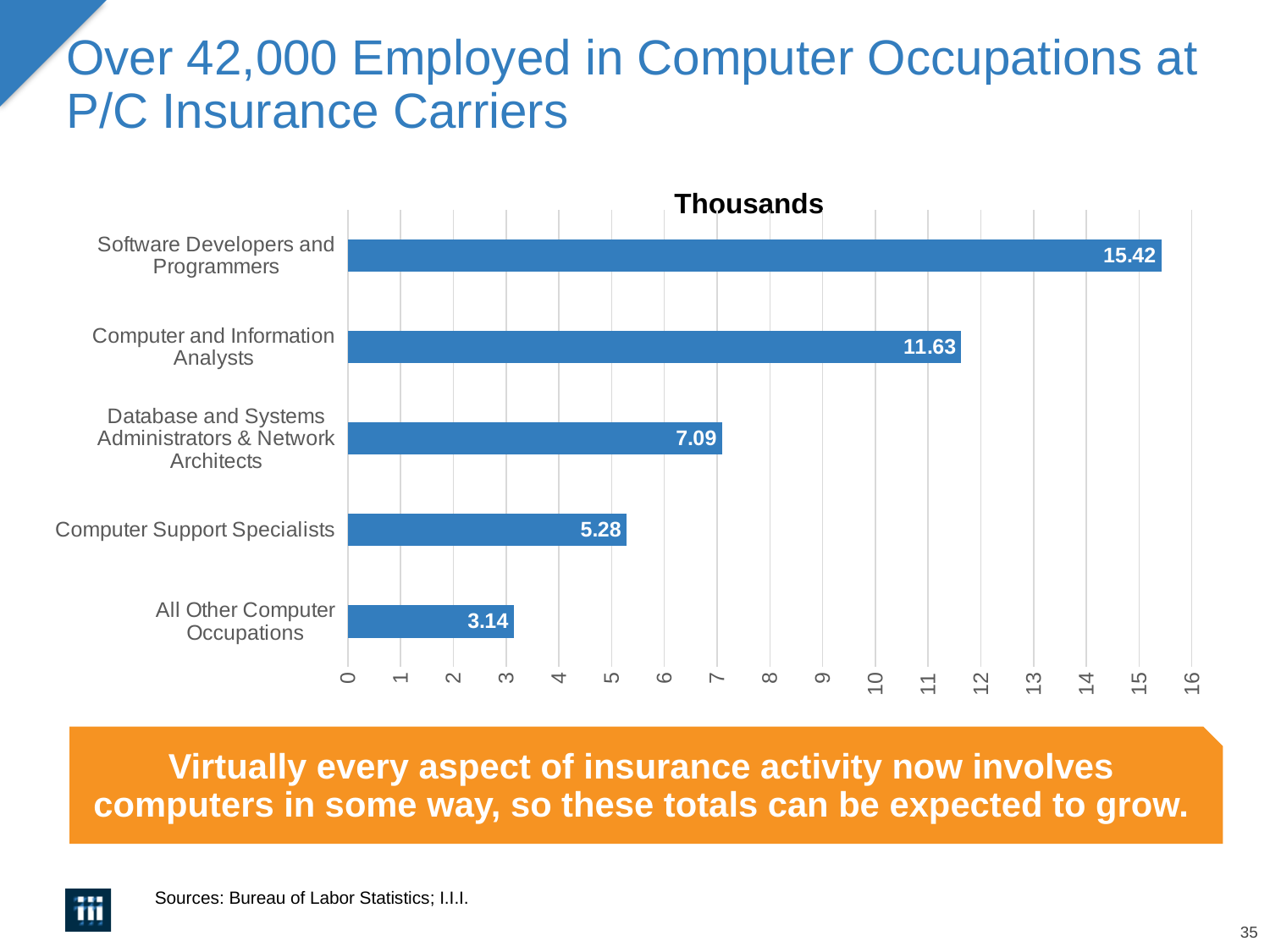
Which is larger, the value for Computer and Information Analysts or the value for Database and Systems Administrators & Network Architects? Computer and Information Analysts What kind of chart is shown on the slide? bar chart Which category has the highest value? Software Developers and Programmers What is the value for Database and Systems Administrators & Network Architects? 7.09 What is the title of the chart? Thousands Is the value for Computer and Information Analysts greater or less than 10? greater What is the difference between the values for Software Developers and Programmers and Computer and Information Analysts? 3.79 How many categories are shown in the chart? 5 What is the value for Computer Support Specialists? 5.28 What is the value for Software Developers and Programmers? 15.42 What is the difference between the values for Computer Support Specialists and All Other Computer Occupations? 2.14 Which category has the lowest value? All Other Computer Occupations